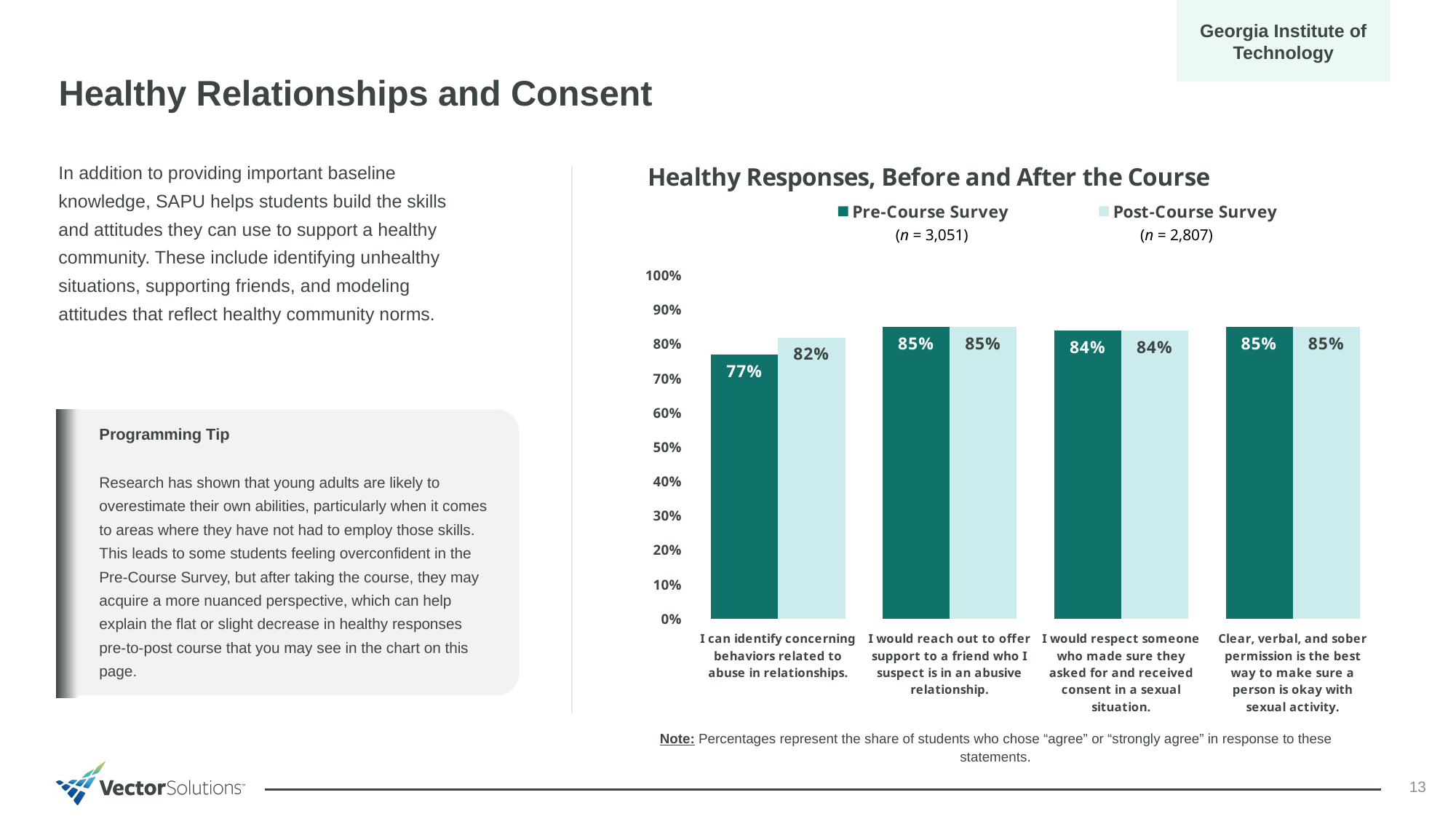
What kind of chart is shown on the slide? Bar chart What is the Post-Course Survey value for "Clear, verbal, and sober permission is the best way to make sure a person is okay with sexual activity."? 85% Which is larger for "I can identify concerning behaviors related to abuse in relationships.": the Pre-Course Survey value or the Post-Course Survey value? Post-Course Survey What is the Pre-Course Survey value for "I would respect someone who made sure they asked for and received consent in a sexual situation."? 84% What is the title of the chart? Healthy Responses, Before and After the Course What is the Post-Course Survey value for "I can identify concerning behaviors related to abuse in relationships."? 82% Is the Pre-Course Survey value for "I would reach out to offer support to a friend who I suspect is in an abusive relationship." greater or less than 80%? greater How many series does the chart's legend list? 2 What is the Pre-Course Survey value for "I can identify concerning behaviors related to abuse in relationships."? 77% How many statements (categories) are shown on the x axis of the chart? 4 Which statement has the lowest Pre-Course Survey value? I can identify concerning behaviors related to abuse in relationships. What is the difference between the Post-Course and Pre-Course Survey values for "I can identify concerning behaviors related to abuse in relationships."? 5%